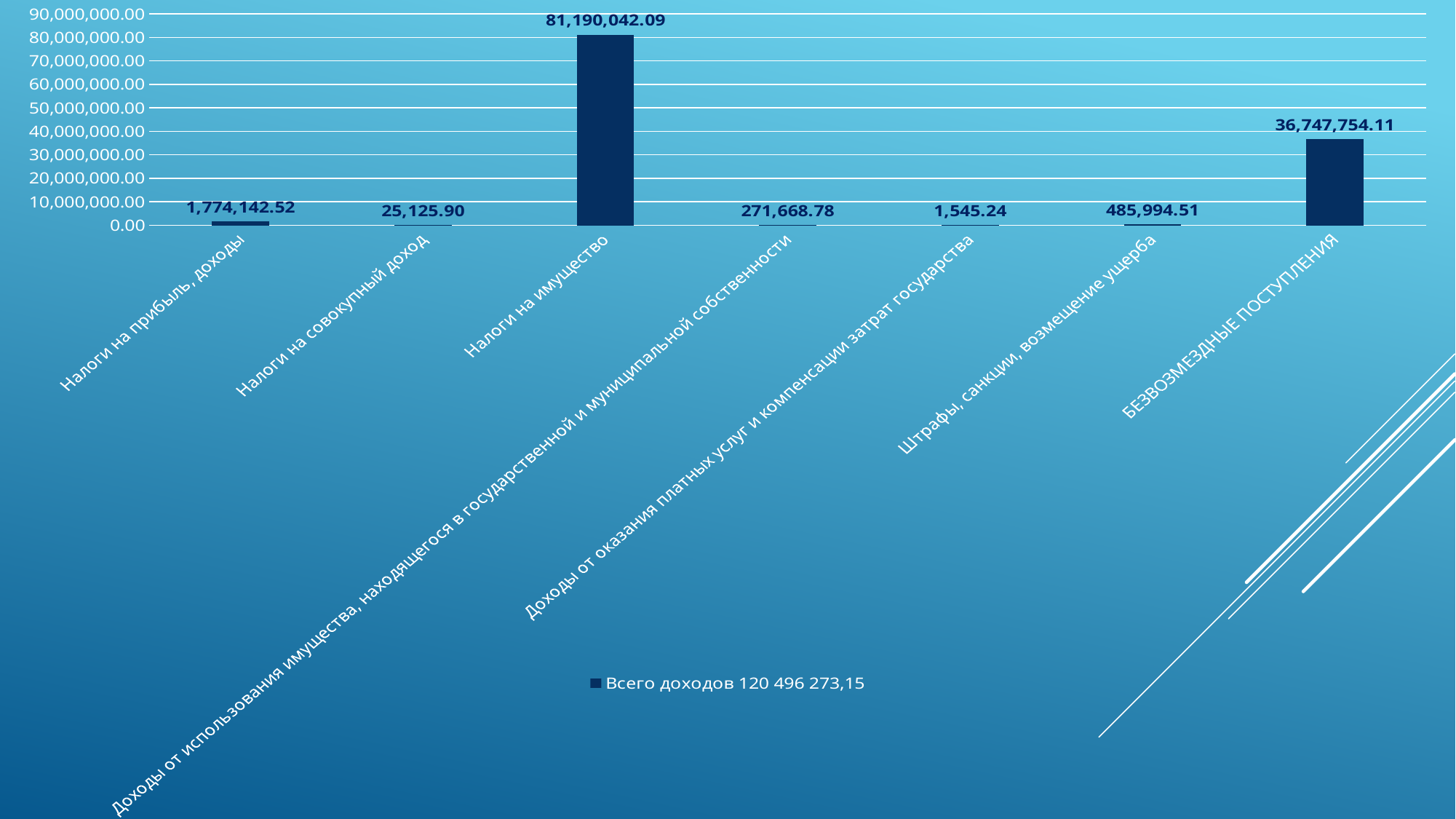
Which is larger: the value for "Налоги на совокупный доход" or the value for "Доходы от использования имущества, находящегося в государственной и муниципальной собственности"? Доходы от использования имущества, находящегося в государственной и муниципальной собственности What is the legend entry for the series? Всего доходов 120 496 273,15 Which category has the highest value? Налоги на имущество Which category has the lowest value? Доходы от оказания платных услуг и компенсации затрат государства What type of chart is shown on the slide? bar chart What is the value for "БЕЗВОЗМЕЗДНЫЕ ПОСТУПЛЕНИЯ"? 36,747,754.11 What is the value for "Налоги на имущество"? 81,190,042.09 What is the value for "Налоги на прибыль, доходы"? 1,774,142.52 Is the value for "БЕЗВОЗМЕЗДНЫЕ ПОСТУПЛЕНИЯ" greater or less than 30,000,000.00? greater How many categories are shown on the x axis? 7 What is the value for "Штрафы, санкции, возмещение ущерба"? 485,994.51 What is the difference between the values for "Налоги на имущество" and "БЕЗВОЗМЕЗДНЫЕ ПОСТУПЛЕНИЯ"? 44,442,287.98